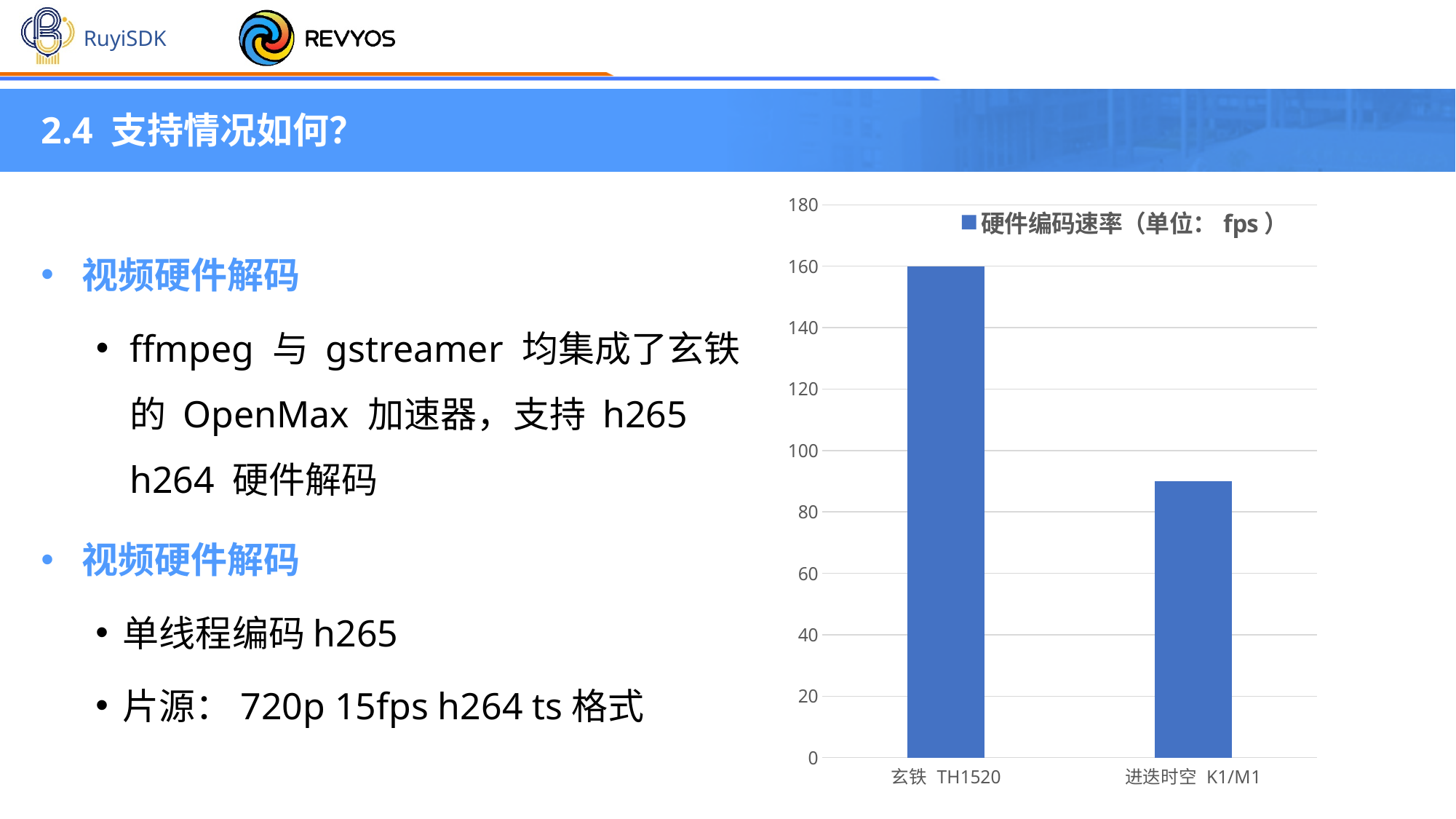
Is the value for 进迭时空 K1/M1 greater or less than 100? less Which category has the lowest hardware encoding rate? 进迭时空 K1/M1 What is the maximum value shown on the chart's vertical axis? 180 How many series does the chart legend list? 1 What kind of chart is shown on the slide? bar chart Which has a larger hardware encoding rate, 玄铁 TH1520 or 进迭时空 K1/M1? 玄铁 TH1520 What is the legend entry of the chart? 硬件编码速率（单位： fps） Is the value for 玄铁 TH1520 greater or less than 140? greater What is the hardware encoding rate for 玄铁 TH1520? 160 Is the value for 进迭时空 K1/M1 greater or less than 80? greater Which category has the highest hardware encoding rate? 玄铁 TH1520 How many categories are plotted in the chart? 2